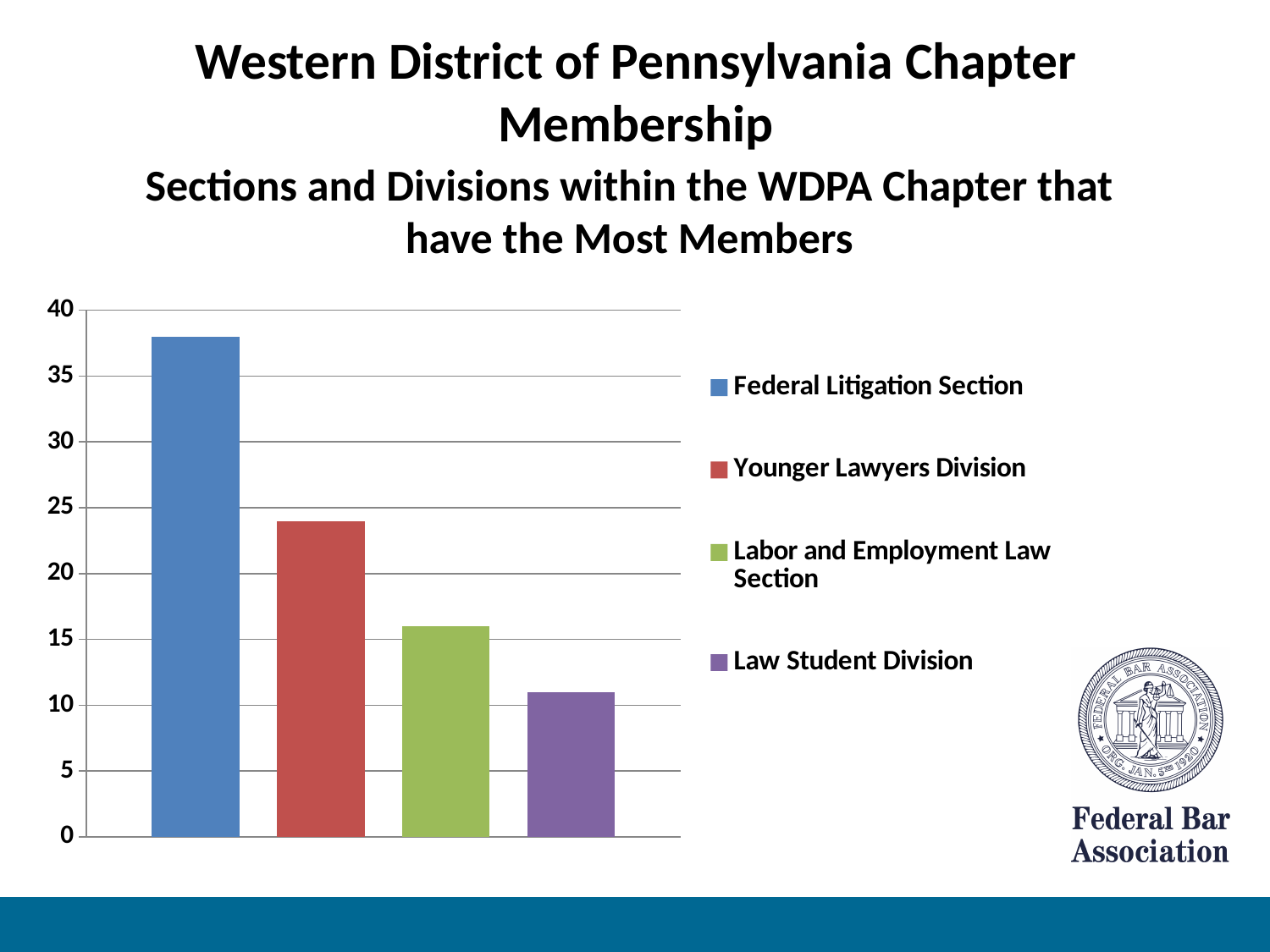
What kind of chart is shown on the slide? bar chart What colour is the bar for Labor and Employment Law Section? green Which is larger, the value for Law Student Division or the value for Federal Litigation Section? Federal Litigation Section How many entries does the legend list? 4 How many bars are plotted in the chart? 4 Is the value for Federal Litigation Section greater or less than 35? greater Which section or division has the highest bar? Federal Litigation Section Which section or division has the lowest bar? Law Student Division Is the value for Younger Lawyers Division greater or less than 25? less Is the value for Law Student Division greater or less than 15? less Which is larger, the value for Younger Lawyers Division or the value for Labor and Employment Law Section? Younger Lawyers Division